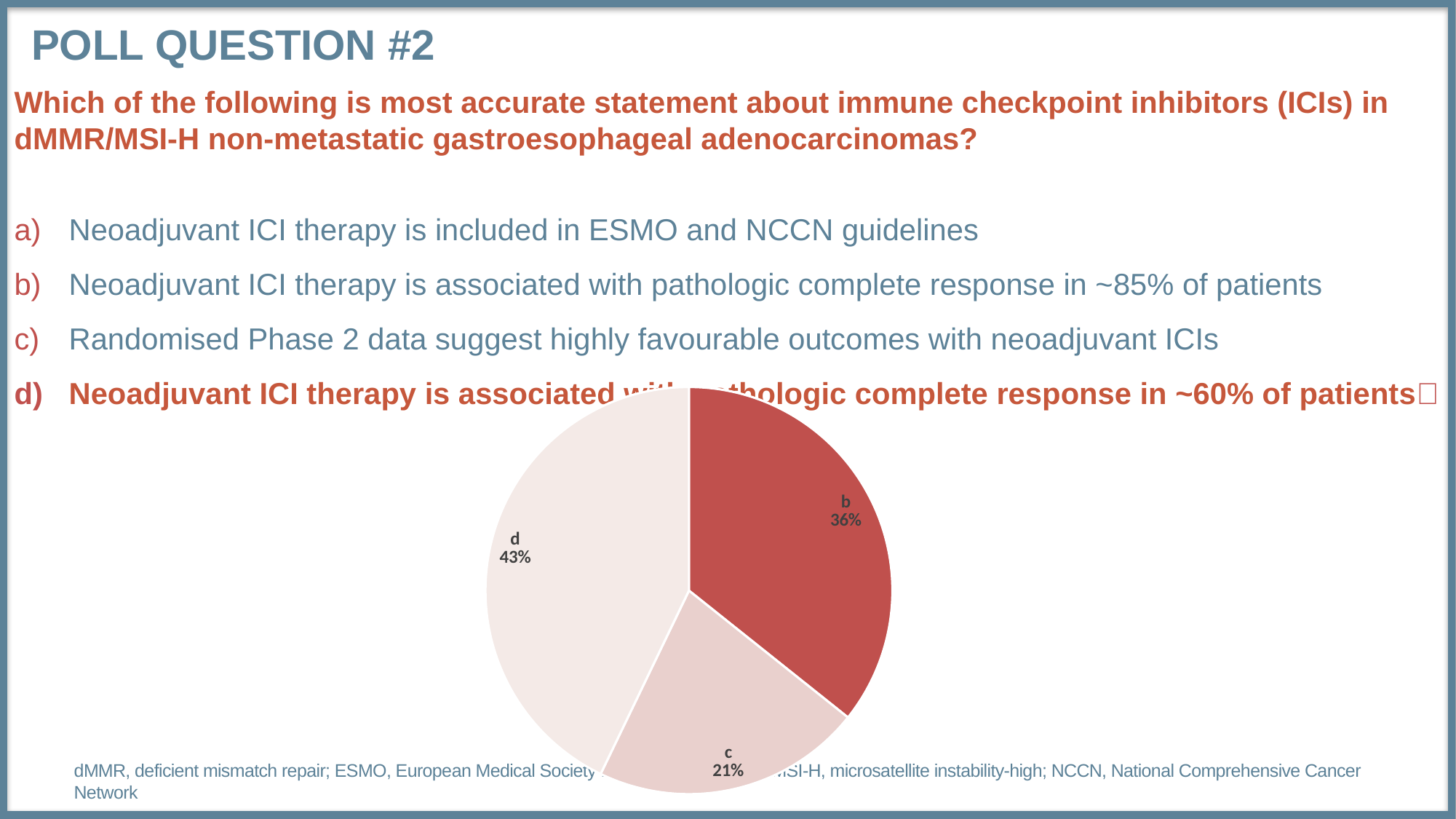
Which option has the smallest slice of the pie? c How many slices does the pie chart have? 3 What is the combined percentage of options b and c? 57% What percentage of the pie is labelled for option c? 21% What is the difference in percentage points between option b and option c? 15 What percentage of the pie is labelled for option d? 43% What percentage of the pie is labelled for option b? 36% Which slice is larger, option b or option c? b What kind of chart is shown on the slide? pie chart What is the difference in percentage points between option d and option b? 7 Which option has the largest slice of the pie? d Which slice of the pie is coloured dark red? b